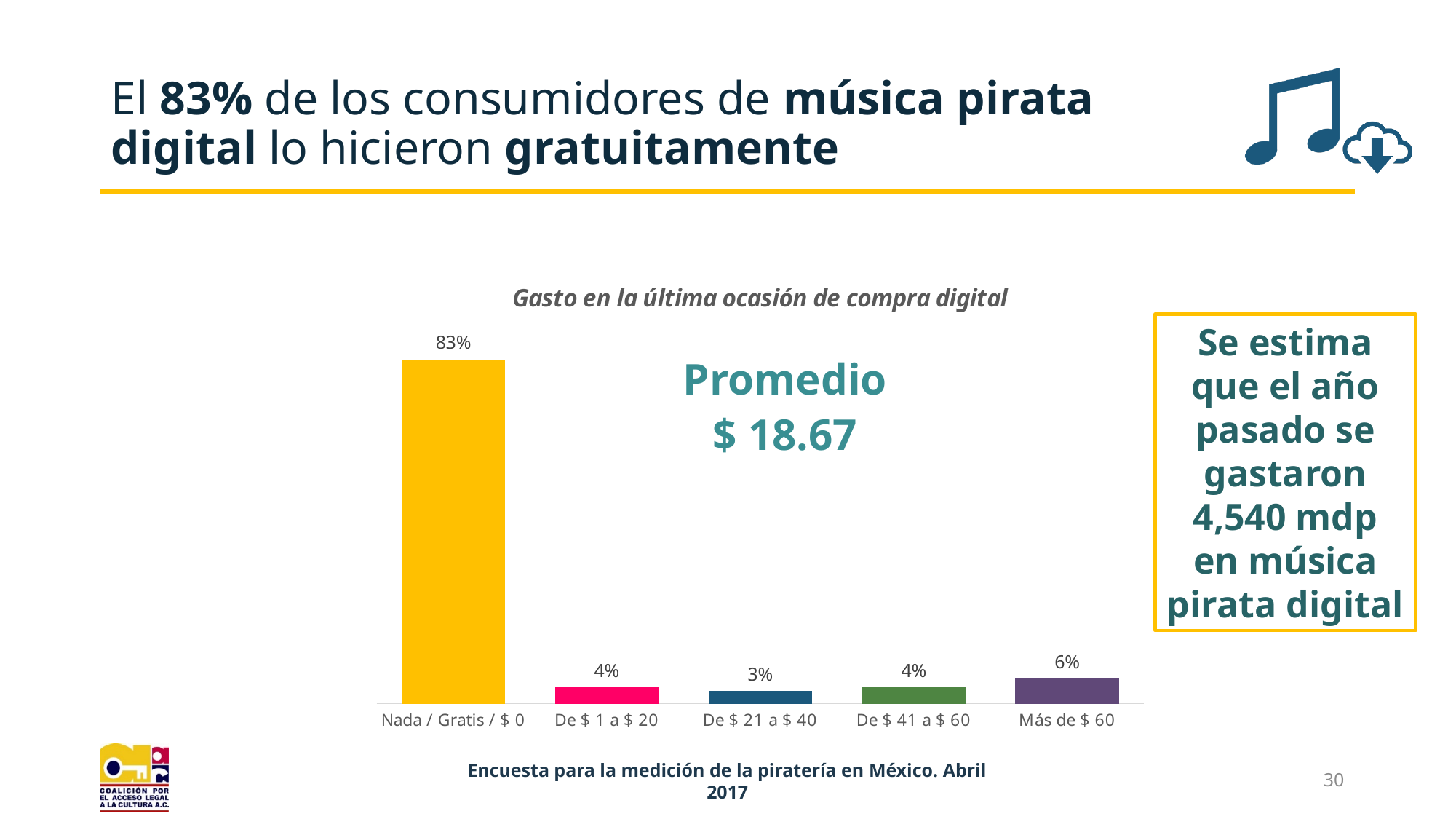
What kind of chart is shown on the slide? Bar chart What is the value for the 'De $ 21 a $ 40' category? 3% What is the difference between the values for 'Más de $ 60' and 'De $ 21 a $ 40'? 3% Which category has the lowest value? De $ 21 a $ 40 Which is larger, the value for 'Más de $ 60' or the value for 'De $ 41 a $ 60'? Más de $ 60 What is the value for the 'Más de $ 60' category? 6% What is the value for the 'Nada / Gratis / $ 0' category? 83% What is the difference between the values for 'Nada / Gratis / $ 0' and 'Más de $ 60'? 77% What is the title of the chart? Gasto en la última ocasión de compra digital What is the value for the 'De $ 1 a $ 20' category? 4% Which category has the highest value? Nada / Gratis / $ 0 How many categories are shown in the chart? 5